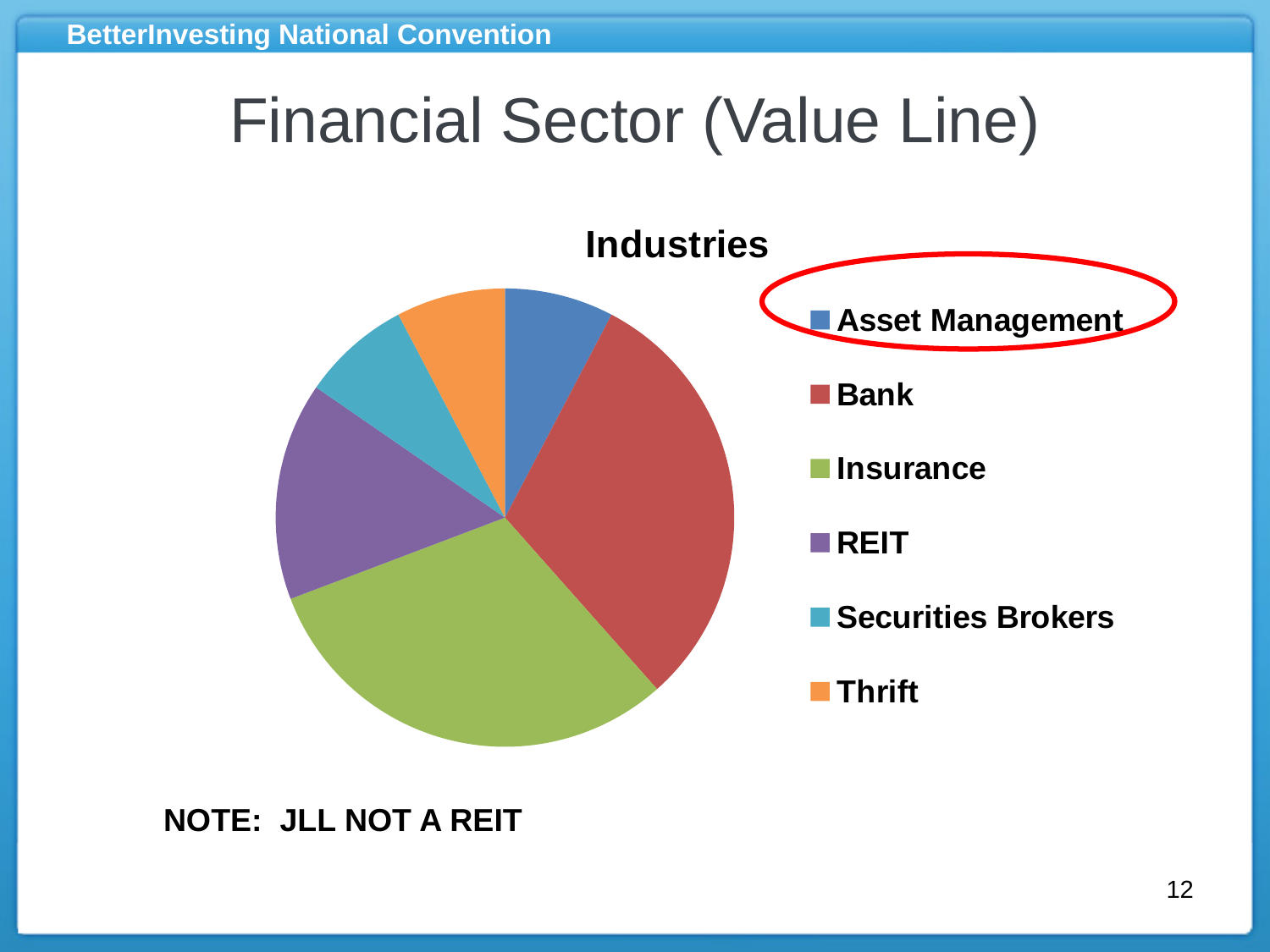
What is the title of the pie chart? Industries How many slices does the pie chart have? 6 What kind of chart is shown on the slide? pie chart Which slice is larger, REIT or Thrift? REIT Which slice is larger, Bank or REIT? Bank How many entries does the legend of the pie chart list? 6 Which slice is larger, Asset Management or Bank? Bank Which legend entry is circled in red? Asset Management